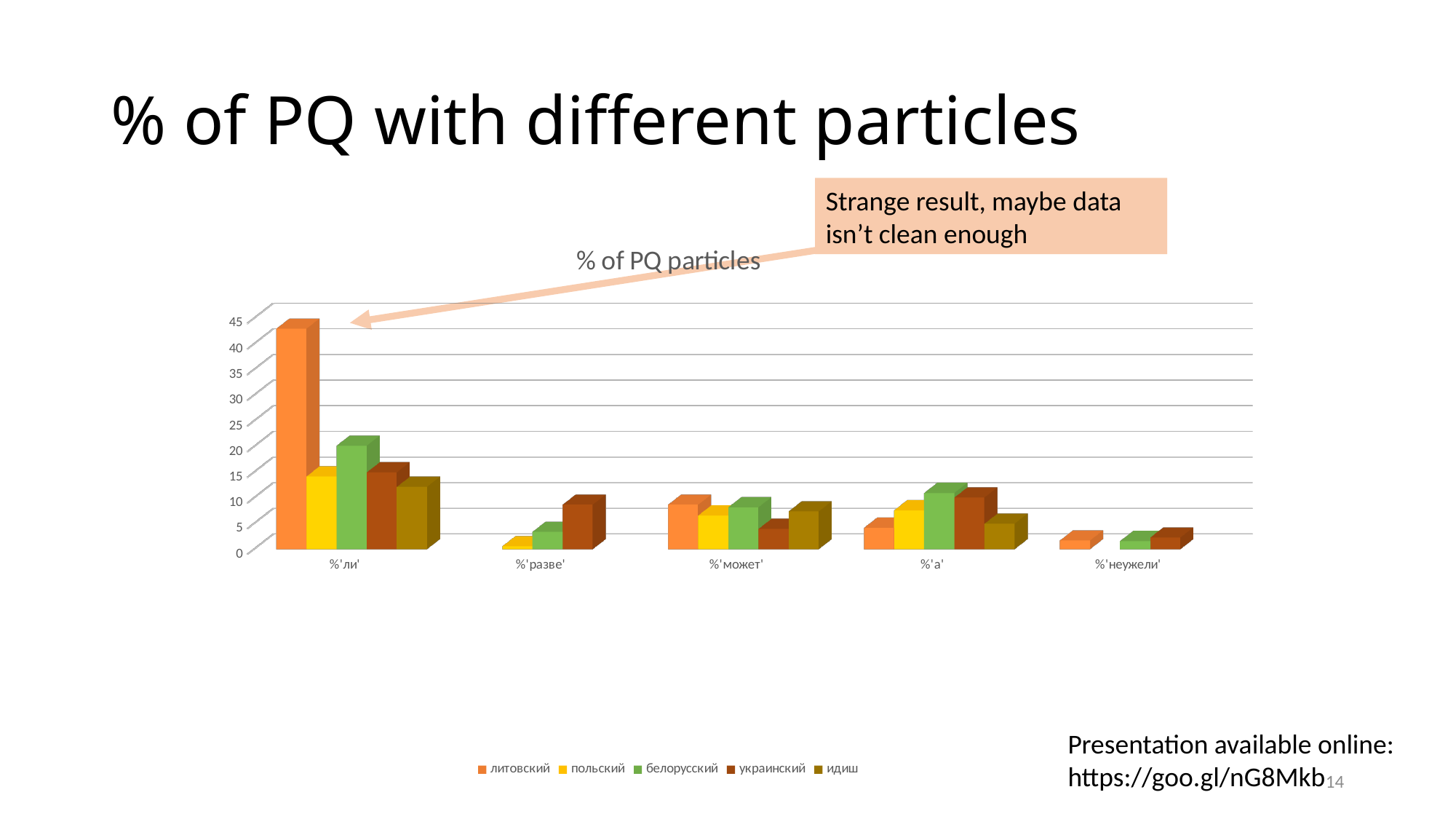
How many categories are shown on the x axis of the chart? 5 Which is larger in the %'ли' category: the литовский value or the белорусский value? литовский Is the value for литовский in the %'ли' category greater or less than 35? greater What kind of chart is shown on the slide? bar chart Is the value for белорусский in the %'ли' category greater or less than 15? greater What is the title of the chart? % of PQ particles How many series does the chart legend list? 5 For which category is the литовский bar the highest? %'ли' Which series has the highest value in the %'разве' category? украинский Which series has the highest value in the %'ли' category? литовский Which series is listed first in the chart legend? литовский Is the value for украинский in the %'разве' category greater or less than 15? less